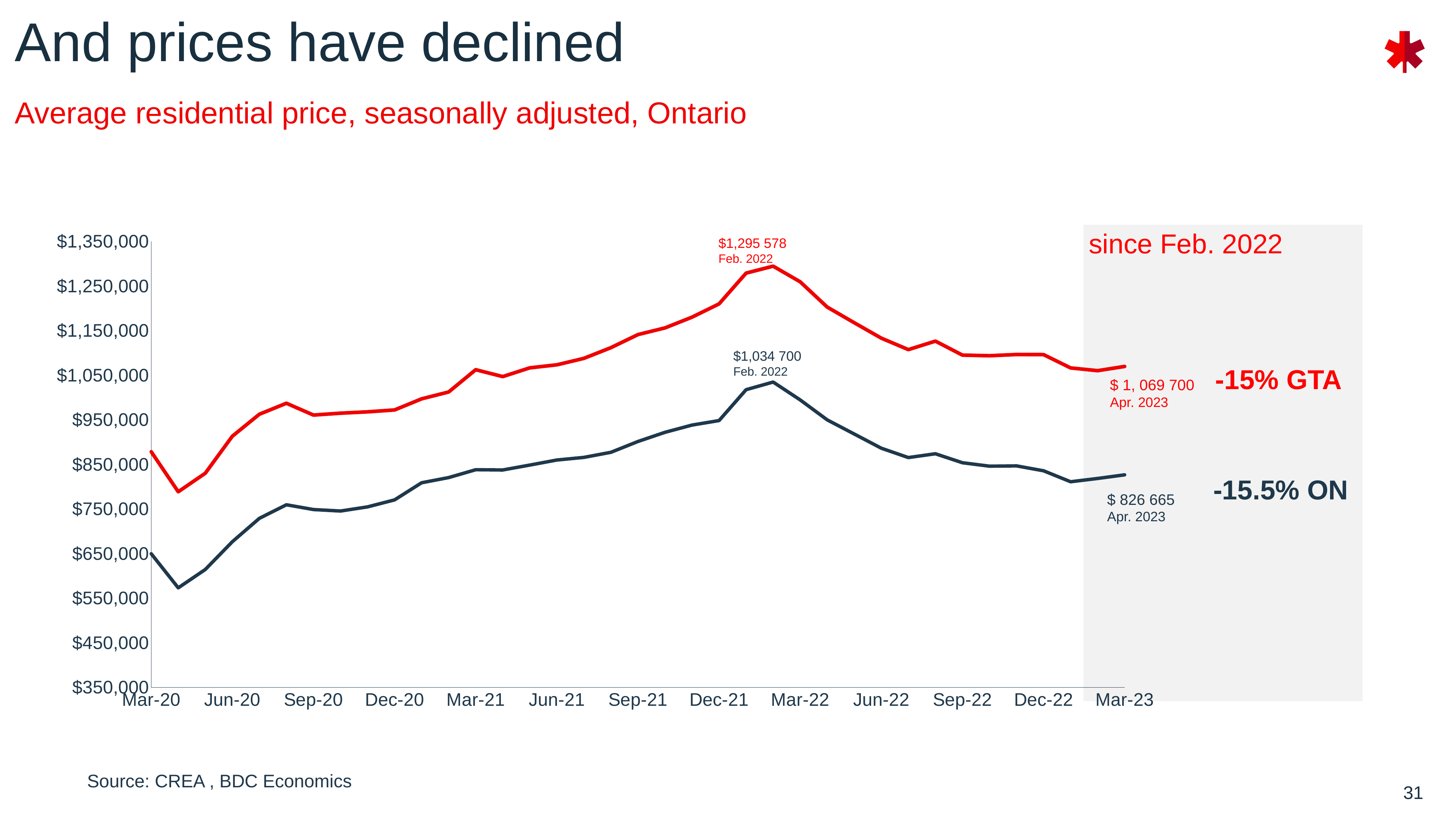
Do prices rise or fall between Feb. 2022 and Apr. 2023? fall What percentage change since Feb. 2022 is shown for Ontario (ON)? -15.5% What was the GTA average residential price in Apr. 2023? $ 1, 069 700 What was the GTA average residential price at its Feb. 2022 peak? $1,295 578 Which series had the higher price in Feb. 2022, GTA or ON? GTA What kind of chart is shown on the slide? line chart What was the Ontario (ON) average residential price in Feb. 2022? $1,034 700 What was the Ontario (ON) average residential price in Apr. 2023? $ 826 665 How many lines are plotted on the chart? 2 By how much did the GTA average price fall from Feb. 2022 to Apr. 2023, in dollars? $225,878 By how much did the Ontario (ON) average price fall from Feb. 2022 to Apr. 2023, in dollars? $208,035 Is the Ontario (ON) price in Apr-20 greater or less than $650,000? less